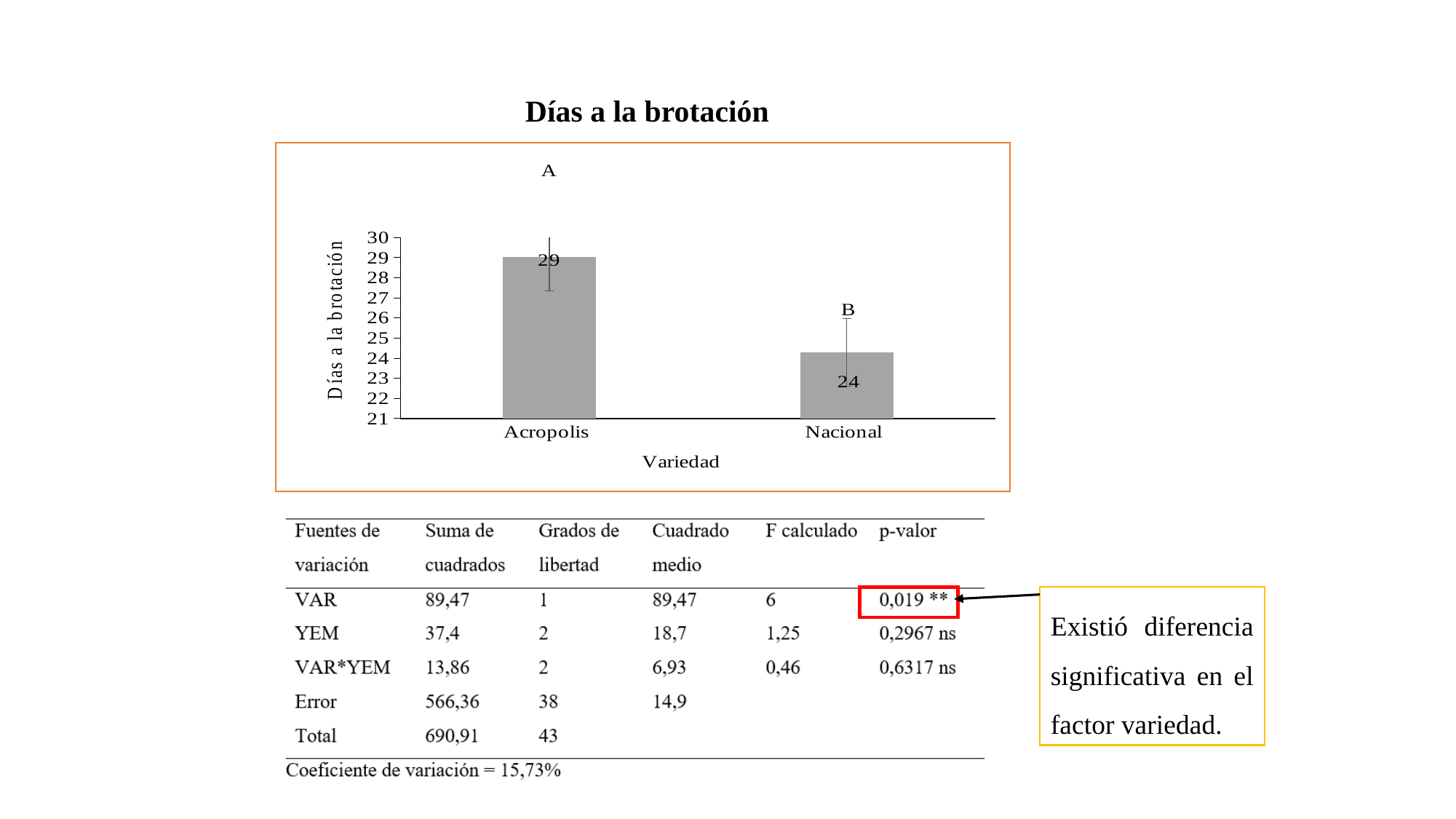
Is the value for Nacional in the chart greater or less than 26? less Do the values in the chart rise or fall from Acropolis to Nacional? fall What is the label of the x axis of the chart? Variedad Which variety has the highest days to sprouting in the chart? Acropolis What is the value for Nacional in the Días a la brotación chart? 24 What is the value for Acropolis in the Días a la brotación chart? 29 What is the title of the chart on the slide? Días a la brotación Which is larger in the chart, the value for Acropolis or the value for Nacional? Acropolis What is the difference between the values for Acropolis and Nacional in the chart? 5 Which variety has the lowest days to sprouting in the chart? Nacional What kind of chart is shown on the slide? bar chart How many varieties are plotted in the Días a la brotación chart? 2